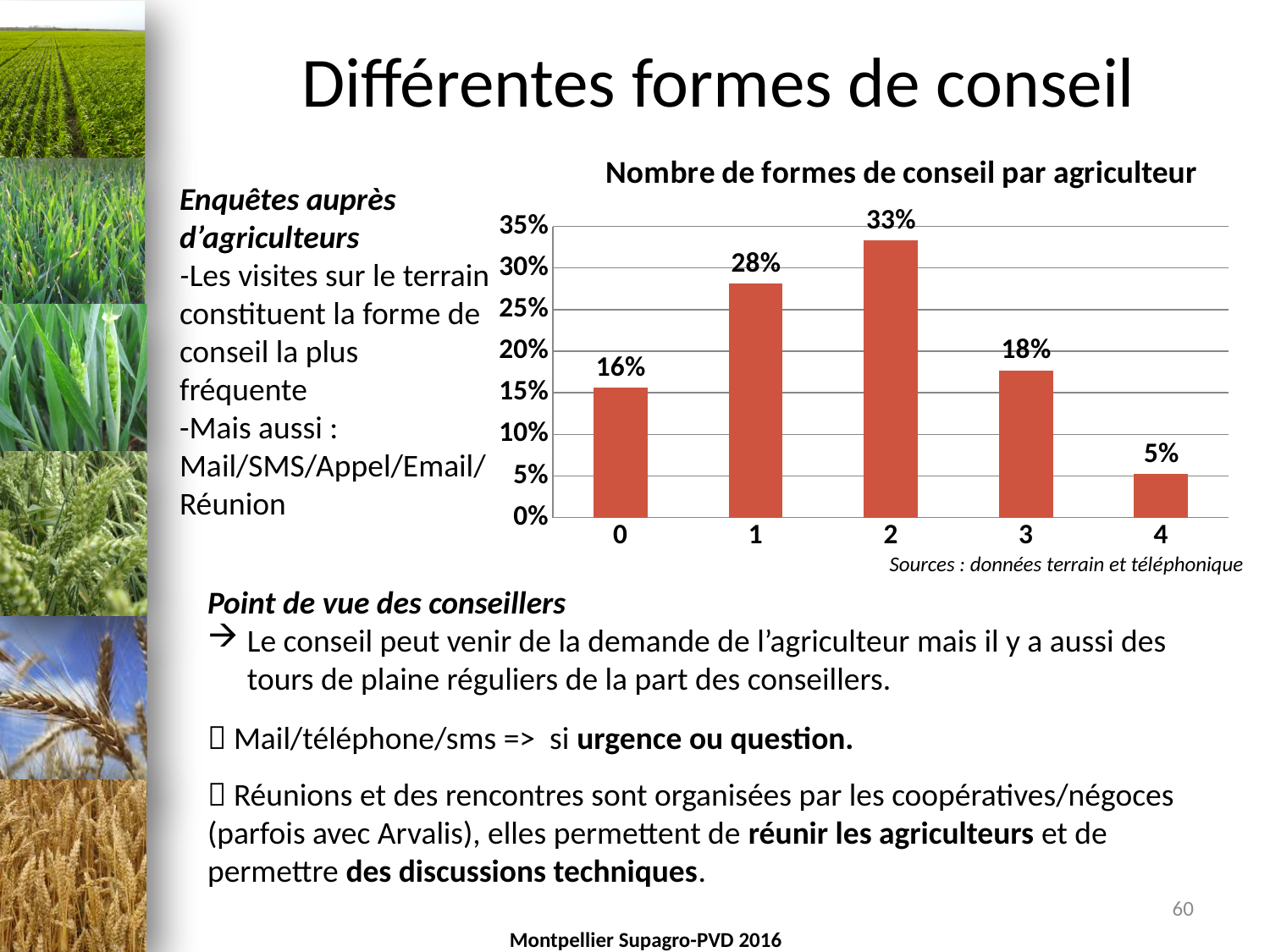
Which category has the lowest value? 4 What is the value for category 0? 16% What kind of chart is shown on the slide? bar chart What is the value for category 4? 5% What is the title of the chart? Nombre de formes de conseil par agriculteur What is the difference between the values for categories 3 and 4? 13% Is the value for category 3 greater or less than 20%? less What is the difference between the values for categories 2 and 1? 5% How many categories are shown on the x axis? 5 Which is larger, the value for category 1 or the value for category 3? 1 Which category has the highest value? 2 What is the value for category 2? 33%